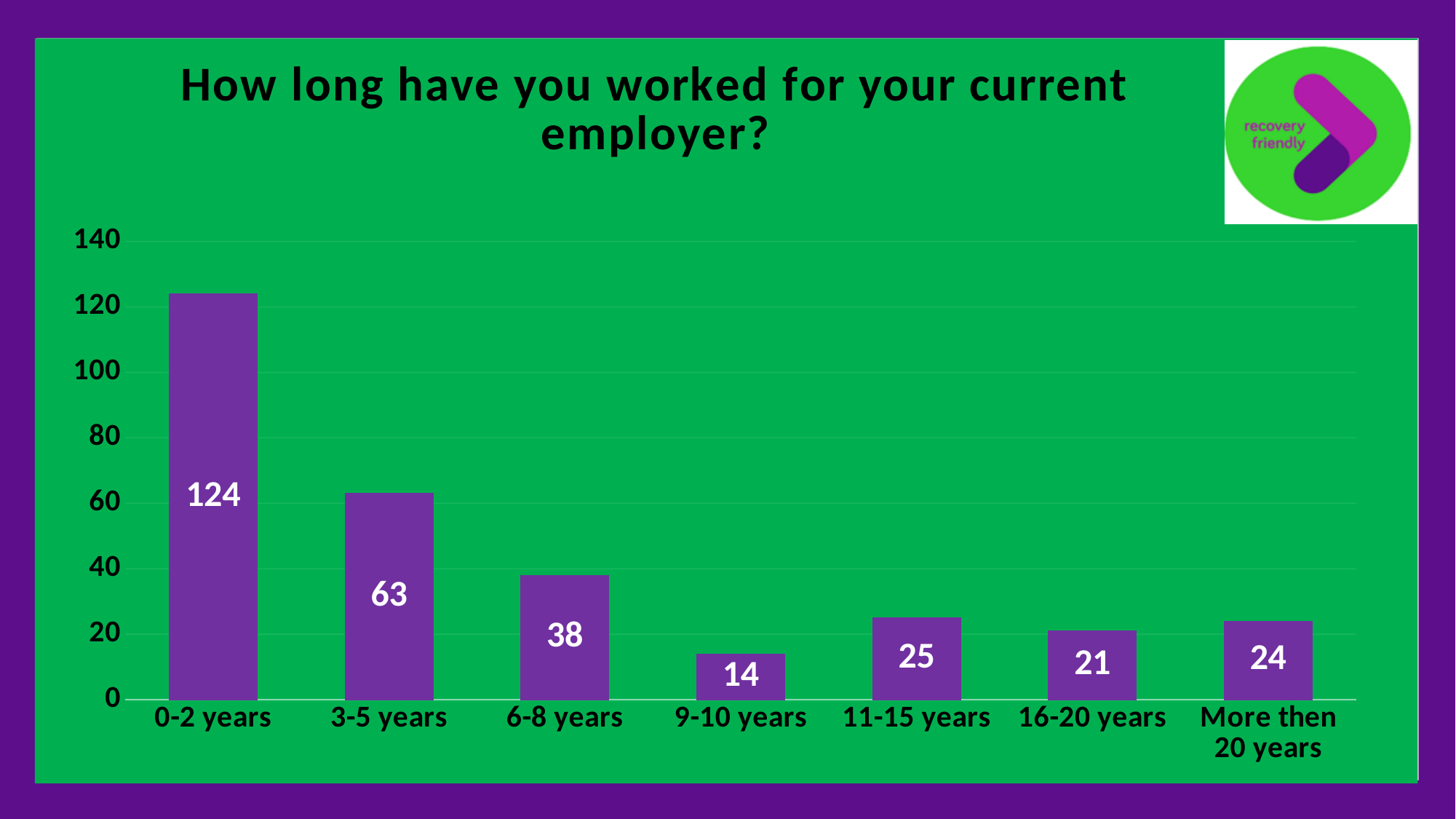
Which category has the lowest value? 9-10 years Which category has the highest value? 0-2 years What is the value for More then 20 years? 24 What kind of chart is shown on the slide? bar chart What is the difference between the values for 11-15 years and 16-20 years? 4 What is the title of the chart? How long have you worked for your current employer? Is the value for 3-5 years greater or less than 80? less How many categories are shown on the x axis? 7 What is the value for 9-10 years? 14 Which is larger, the value for 6-8 years or the value for 11-15 years? 6-8 years What is the value for 0-2 years? 124 What is the difference between the values for 0-2 years and 3-5 years? 61